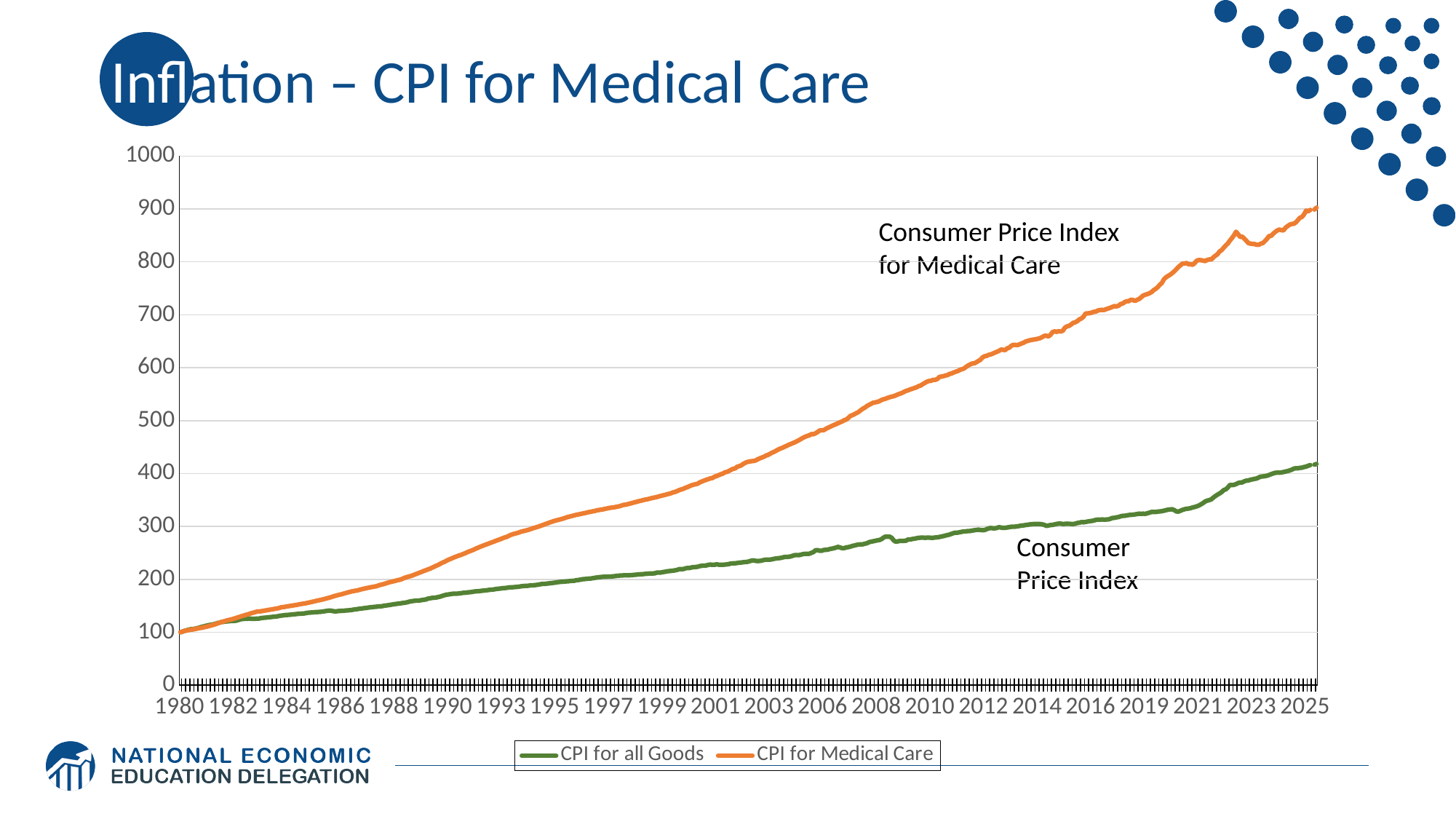
What is the title of the slide? Inflation – CPI for Medical Care What colour is the CPI for Medical Care line? orange Is the value for CPI for all Goods in 2025 greater or less than 500? less Is the value for CPI for all Goods in 2010 greater or less than 300? less What kind of chart is shown on the slide? line chart Which series is higher in 2025, CPI for all Goods or CPI for Medical Care? CPI for Medical Care Is the value for CPI for Medical Care in 2010 greater or less than 500? greater Does the CPI for Medical Care line rise or fall from 1980 to 2025? rise How many series does the legend list? 2 What value do both series start at in 1980? 100